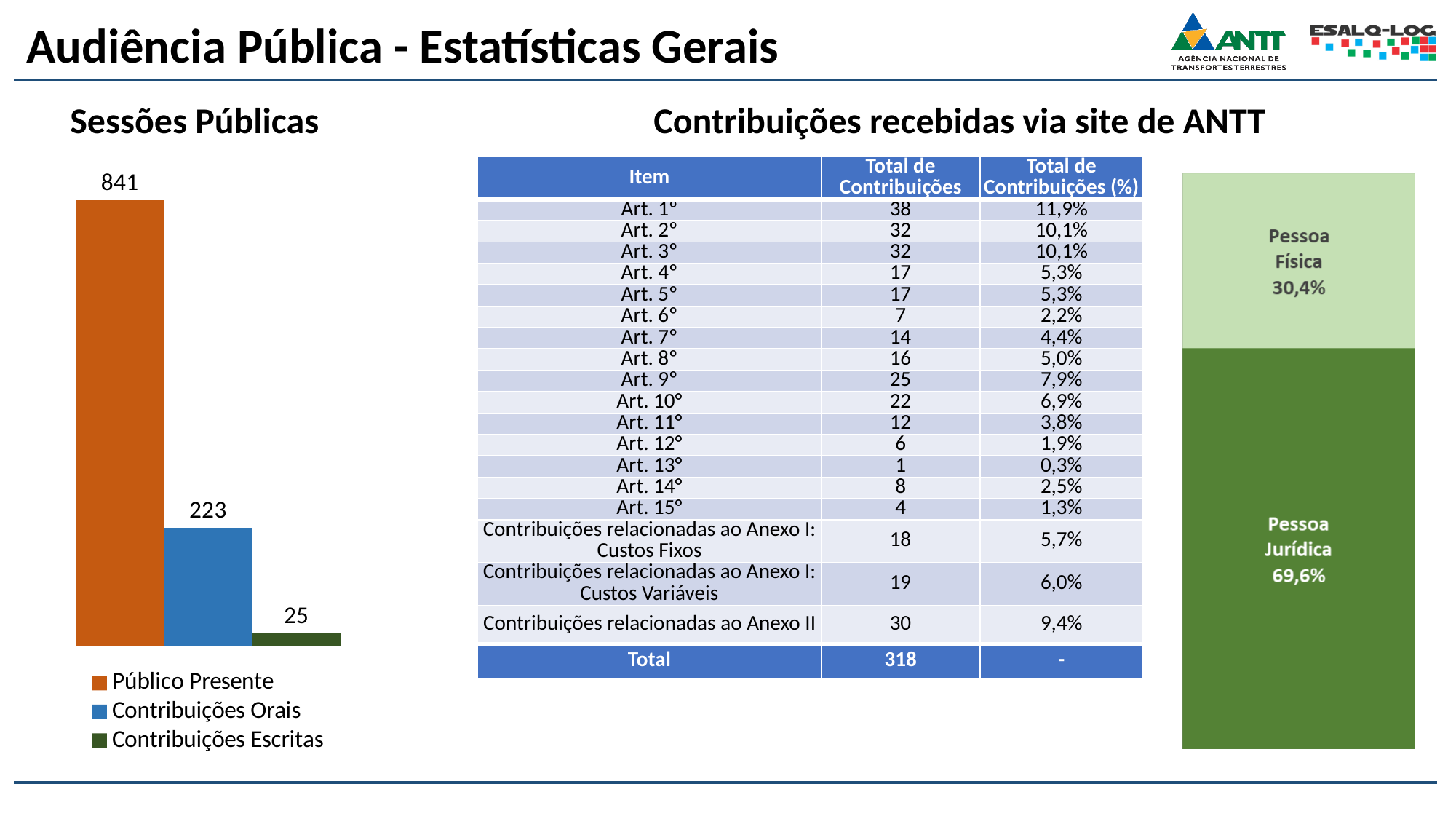
In the stacked bar chart on the right of the slide, what share is shown for Pessoa Física? 30,4% In the 'Sessões Públicas' chart, which is larger: Contribuições Orais or Contribuições Escritas? Contribuições Orais In the 'Sessões Públicas' chart, what is the value for Público Presente? 841 In the 'Sessões Públicas' chart, what is the difference between Público Presente and Contribuições Orais? 618 In the 'Sessões Públicas' chart, which series has the highest value? Público Presente In the stacked bar chart on the right of the slide, which segment is larger: Pessoa Física or Pessoa Jurídica? Pessoa Jurídica In the 'Sessões Públicas' chart, what is the value for Contribuições Escritas? 25 In the 'Sessões Públicas' chart, what is the difference between Contribuições Orais and Contribuições Escritas? 198 In the 'Sessões Públicas' chart, what is the value for Contribuições Orais? 223 What kind of chart is the 'Sessões Públicas' chart? Bar chart In the 'Sessões Públicas' chart, which series has the lowest value? Contribuições Escritas How many series does the legend of the 'Sessões Públicas' chart list? 3